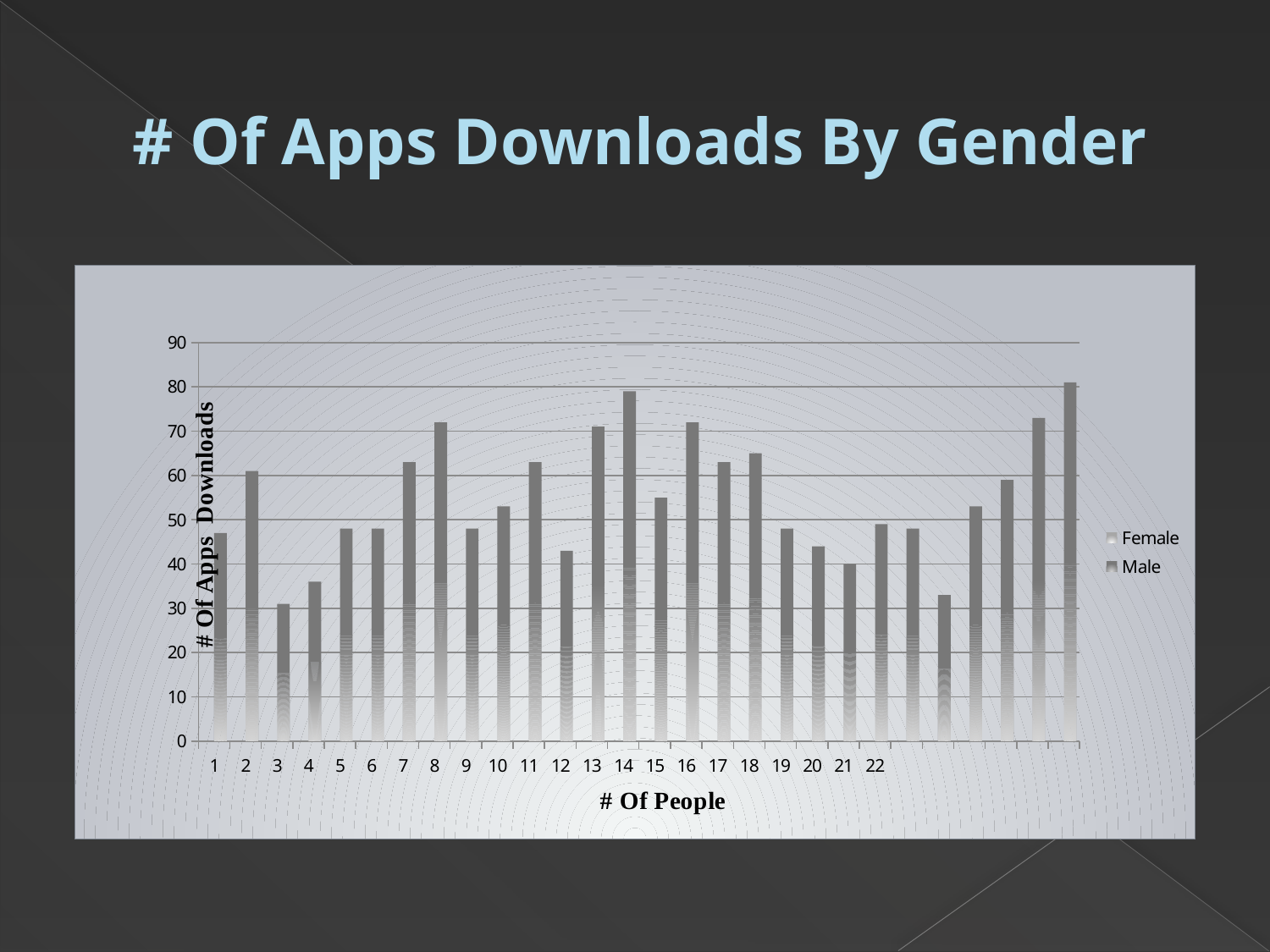
What kind of chart is shown on the slide? bar chart Is the Male value for person 8 greater or less than 60? greater Which has the larger Male value, person 14 or person 12? person 14 Which has the larger Male value, person 16 or person 20? person 16 What is the title of the x axis? # Of People Is the Male value for person 21 greater or less than 50? less Which has the larger Male value, person 2 or person 3? person 2 Is the Male value for person 14 greater or less than 70? greater How many series does the legend list? 2 What are the two series named in the legend? Female and Male